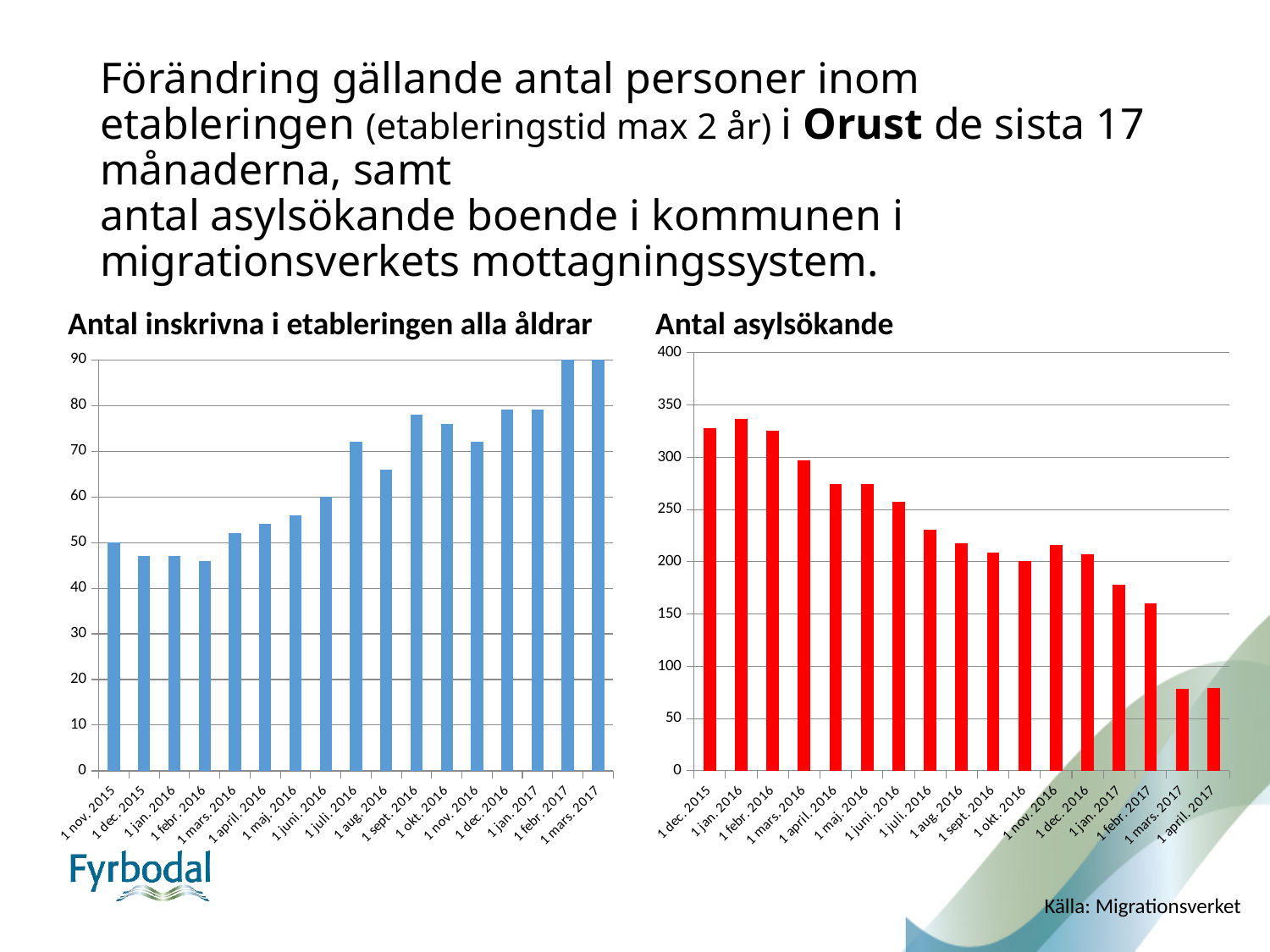
In the right chart "Antal asylsökande", do the values generally rise or fall from 1 dec. 2015 to 1 april 2017? fall In the left chart "Antal inskrivna i etableringen alla åldrar", which is larger, the value for 1 juli 2016 or for 1 aug. 2016? 1 juli 2016 How many bars are shown in the right chart "Antal asylsökande"? 17 In the left chart "Antal inskrivna i etableringen alla åldrar", what is the value for 1 febr. 2017? 90 In the left chart "Antal inskrivna i etableringen alla åldrar", is the value for 1 sept. 2016 greater or less than 70? greater In the left chart "Antal inskrivna i etableringen alla åldrar", do the values generally rise or fall from 1 nov. 2015 to 1 mars 2017? rise In the right chart "Antal asylsökande", is the value for 1 jan. 2017 greater or less than 200? less How many months (bars) are shown in the left chart "Antal inskrivna i etableringen alla åldrar"? 17 In the right chart "Antal asylsökande", which month has the highest value? 1 jan. 2016 In the left chart "Antal inskrivna i etableringen alla åldrar", what is the value for 1 nov. 2015? 50 What kind of chart is the left chart titled "Antal inskrivna i etableringen alla åldrar"? bar chart What colour are the bars in the right chart "Antal asylsökande"? red